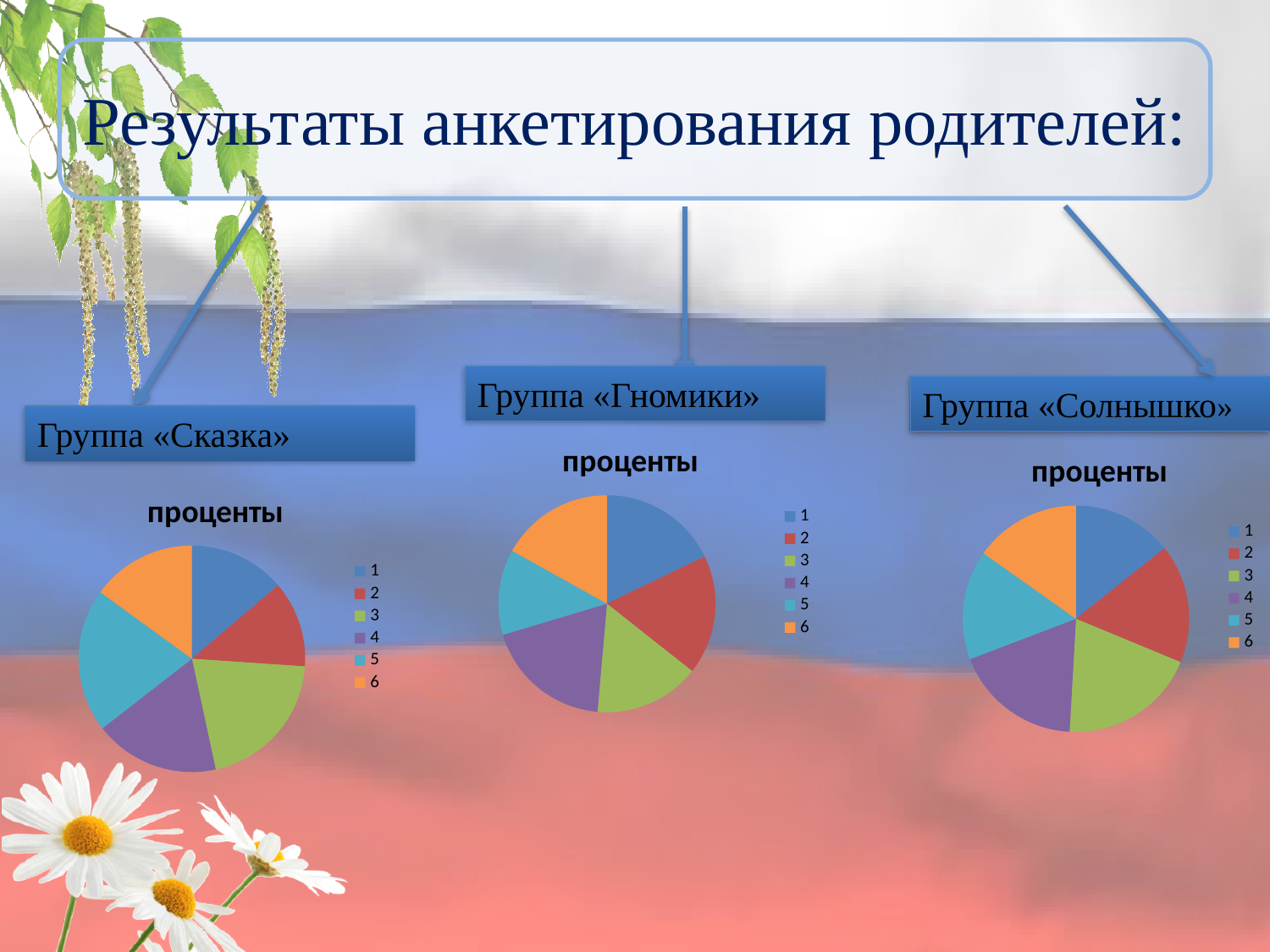
How many slices does the pie chart under Группа «Солнышко» have? 6 What kind of chart is shown under Группа «Солнышко»? pie chart How many entries does the legend of the pie chart under Группа «Сказка» list? 6 What is the title of the pie chart under Группа «Гномики»? проценты How many pie charts are shown on the slide? 3 What kind of chart is shown under Группа «Сказка»? pie chart How many slices does the pie chart under Группа «Сказка» have? 6 What kind of chart is shown under Группа «Гномики»? pie chart In the pie chart under Группа «Сказка», which slice is larger, 5 or 2? 5 How many slices does the pie chart under Группа «Гномики» have? 6 How many entries does the legend of the pie chart under Группа «Солнышко» list? 6